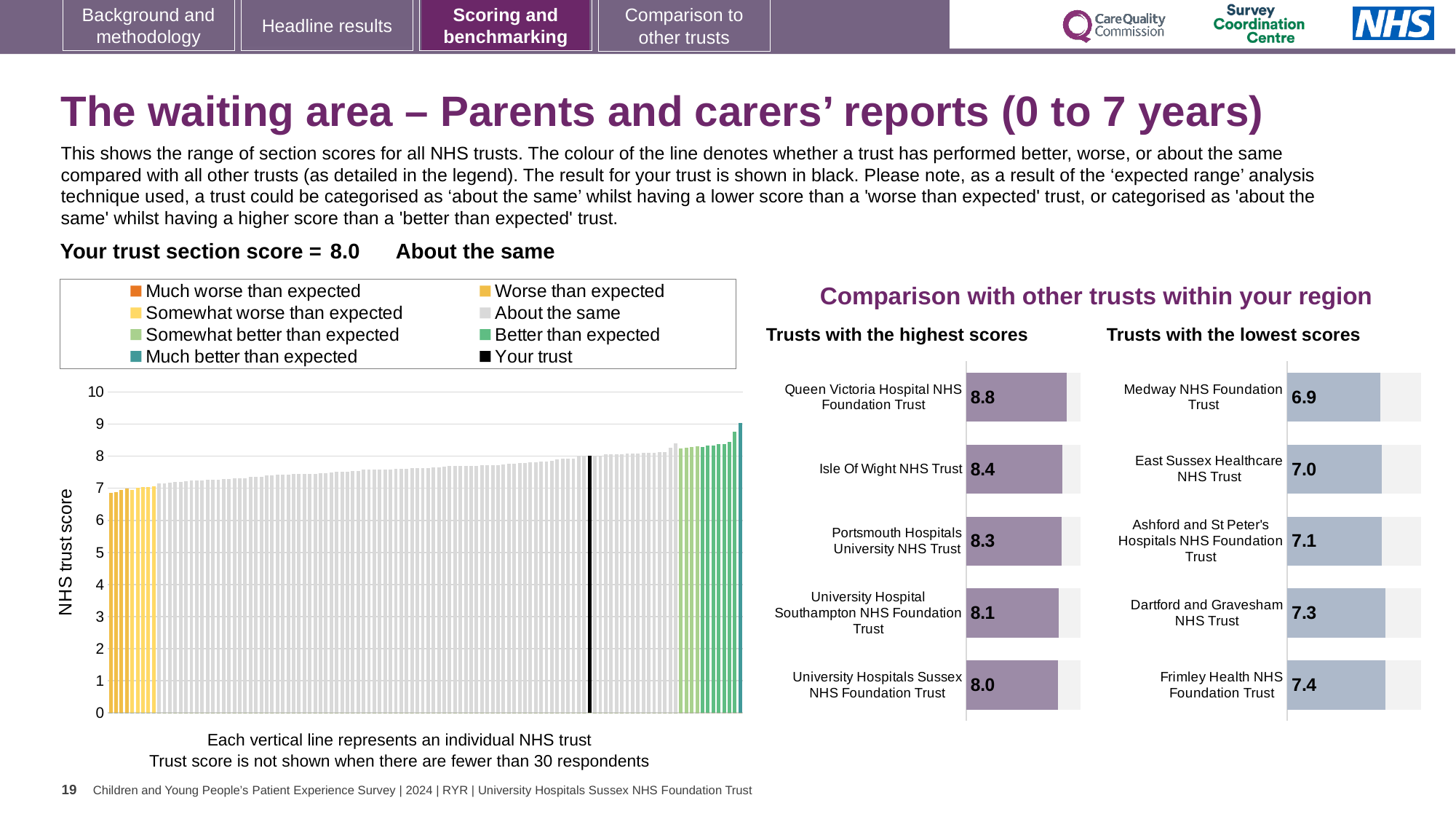
What kind of chart is the chart on the left showing the range of section scores for all NHS trusts? bar chart In the chart on the left showing all NHS trusts, is the value for the black 'Your trust' bar greater or less than 7? greater In the 'Trusts with the highest scores' chart, what is the difference between the scores of Queen Victoria Hospital NHS Foundation Trust and University Hospitals Sussex NHS Foundation Trust? 0.8 How many trusts are shown in the 'Trusts with the highest scores' chart? 5 In the 'Trusts with the highest scores' chart, which trust has the highest score? Queen Victoria Hospital NHS Foundation Trust In the 'Trusts with the highest scores' chart, what is the score for Portsmouth Hospitals University NHS Trust? 8.3 How many entries does the legend of the chart on the left list? 8 In the 'Trusts with the lowest scores' chart, what is the score for Medway NHS Foundation Trust? 6.9 In the 'Trusts with the highest scores' chart, what is the score for Queen Victoria Hospital NHS Foundation Trust? 8.8 In the 'Trusts with the lowest scores' chart, which has the larger score: East Sussex Healthcare NHS Trust or Frimley Health NHS Foundation Trust? Frimley Health NHS Foundation Trust In the 'Trusts with the lowest scores' chart, which trust has the lowest score? Medway NHS Foundation Trust In the 'Trusts with the lowest scores' chart, what is the score for Dartford and Gravesham NHS Trust? 7.3